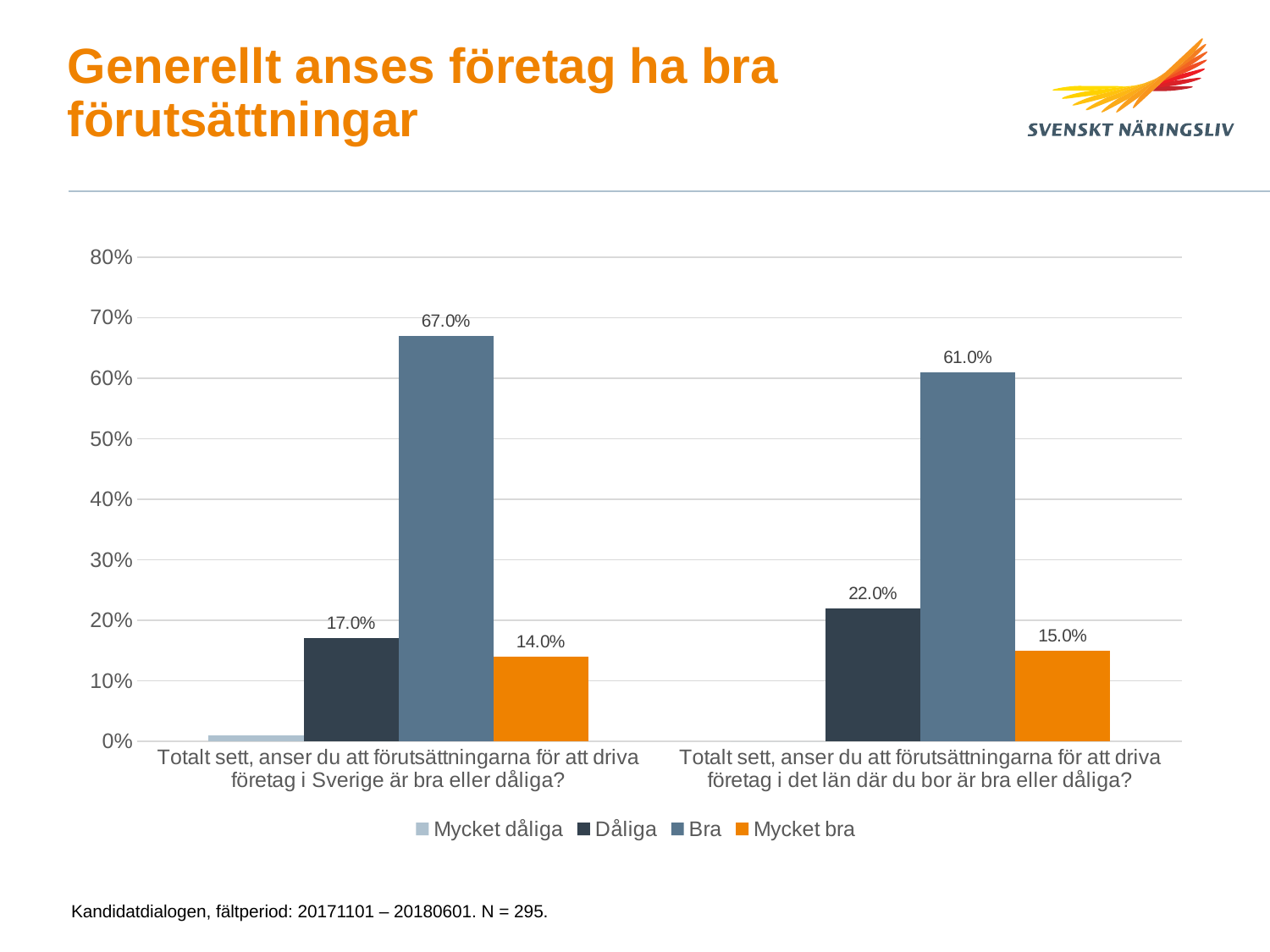
What is the value for "Bra" for the question about driving a company in Sverige? 67.0% What kind of chart is shown on the slide? bar chart What is the value for "Dåliga" for the question about the län where you live? 22.0% How many question categories are shown on the x axis? 2 Which legend entry is shown in orange? Mycket bra What is the value for "Bra" for the question about the län where you live? 61.0% How many series does the legend list? 4 Which is larger: "Dåliga" for the Sverige question or "Dåliga" for the län question? Dåliga for the län question What is the value for "Mycket bra" for the question about driving a company in Sverige? 14.0% What is the difference between the "Bra" values for the Sverige question and the län question? 6.0% Is the value for "Mycket dåliga" for the Sverige question greater or less than 10%? less Which series has the highest value for the question about driving a company in Sverige? Bra